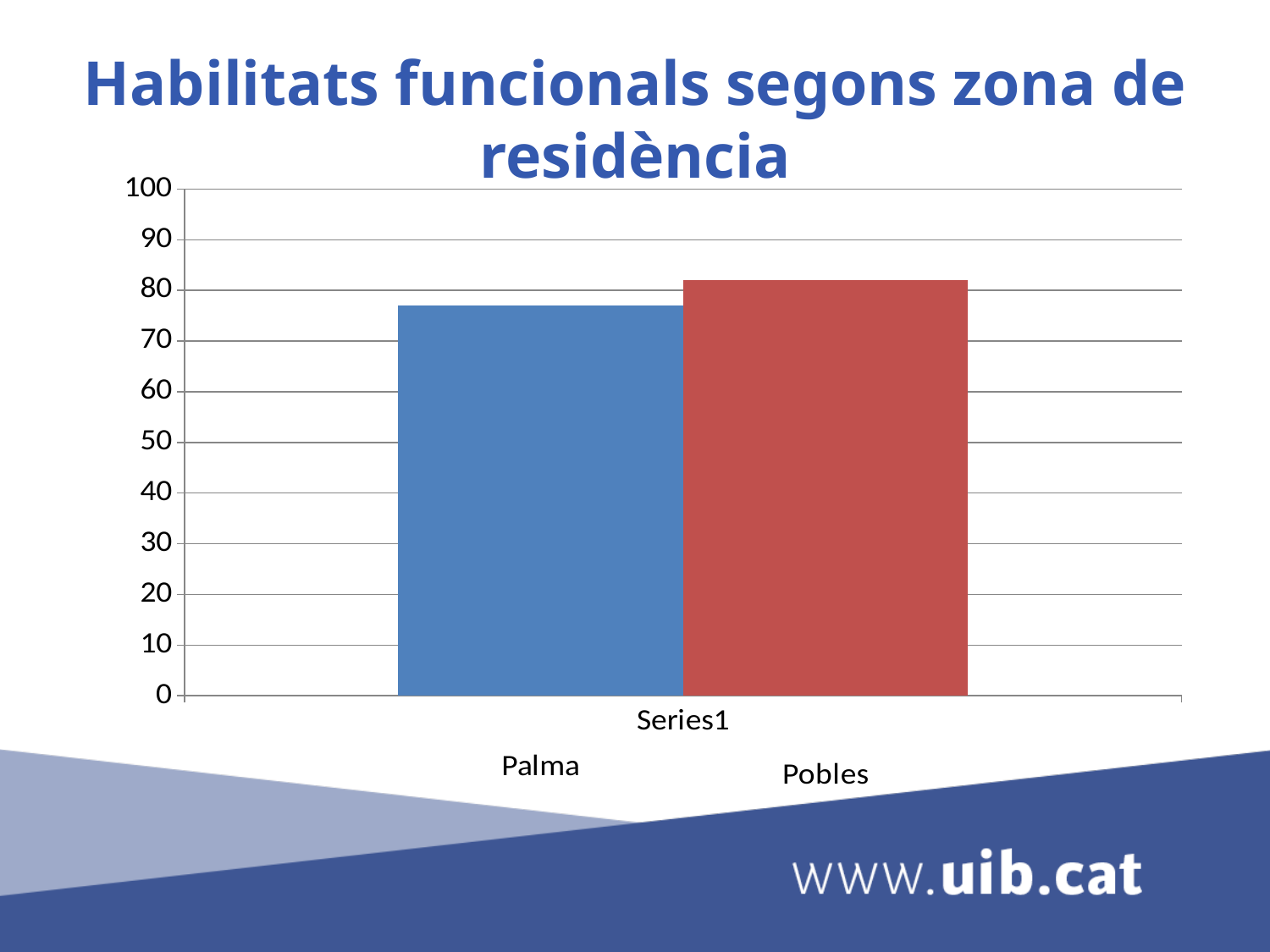
Is the value for Palma greater or less than 80? less Which bar is the lowest in the chart? Palma How many bars are plotted in the chart? 2 What is the title of the chart? Habilitats funcionals segons zona de residència Is the value for Palma greater or less than 70? greater Is the value for Pobles greater or less than 90? less What kind of chart is shown on the slide? bar chart Which bar is the highest, Palma or Pobles? Pobles What colour is the bar for Palma? blue What is the highest value shown on the vertical axis? 100 Which is larger, the value for Palma or the value for Pobles? Pobles